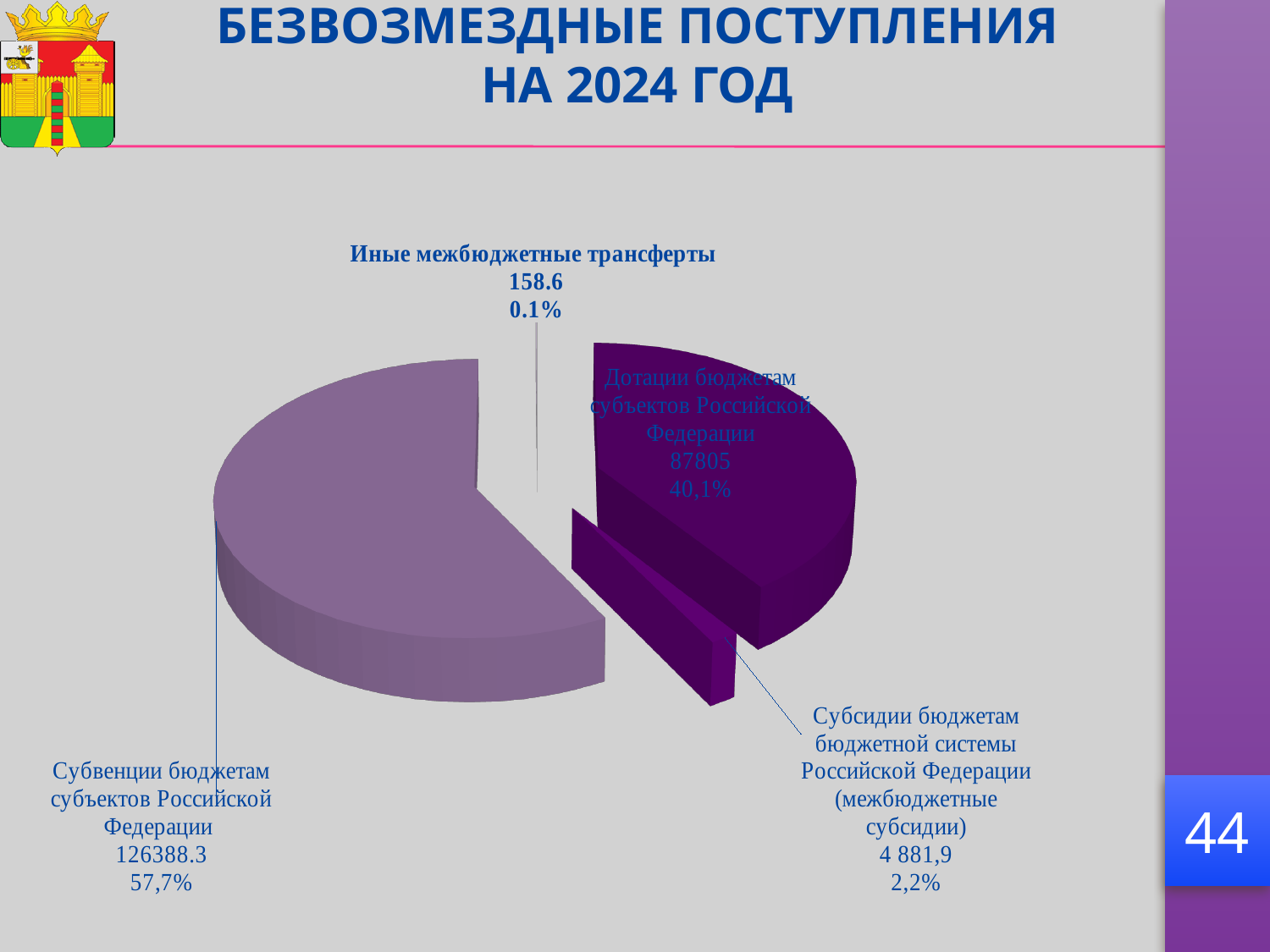
What is the value for Субсидии бюджетам бюджетной системы Российской Федерации (межбюджетные субсидии)? 4 881,9 Which category has the smallest slice? Иные межбюджетные трансферты What share of the pie does Дотации бюджетам субъектов Российской Федерации represent? 40,1% Which category has the largest slice? Субвенции бюджетам субъектов Российской Федерации What is the title of the slide containing the chart? БЕЗВОЗМЕЗДНЫЕ ПОСТУПЛЕНИЯ НА 2024 ГОД What is the value for Субвенции бюджетам субъектов Российской Федерации? 126388.3 What is the value for Иные межбюджетные трансферты? 158.6 What share of the pie does Субвенции бюджетам субъектов Российской Федерации represent? 57,7% Which is larger: Дотации бюджетам субъектов Российской Федерации or Субсидии бюджетам бюджетной системы Российской Федерации? Дотации бюджетам субъектов Российской Федерации What is the value for Дотации бюджетам субъектов Российской Федерации? 87805 How many slices does the pie chart have? 4 What kind of chart is shown on the slide? pie chart